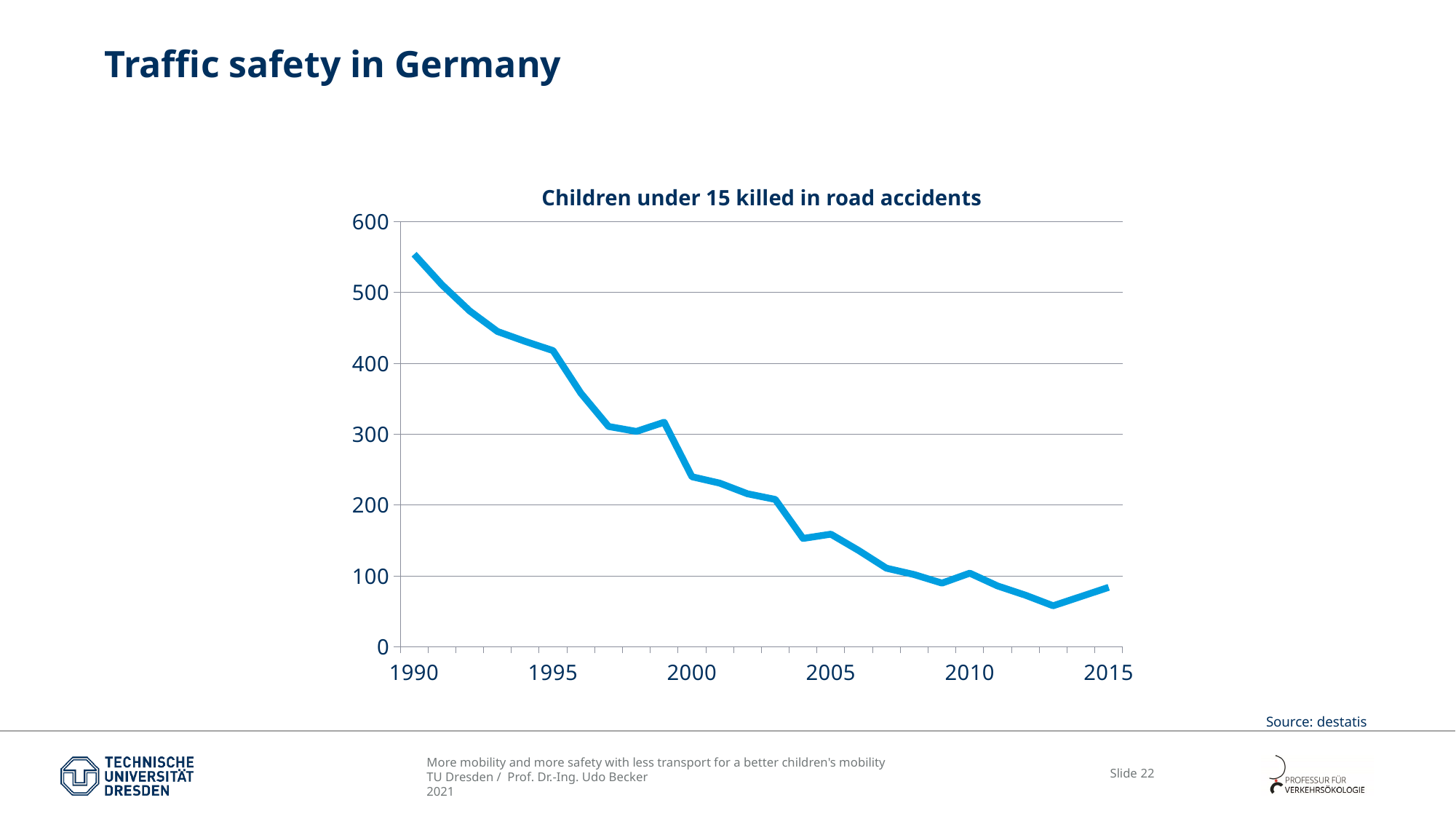
In which year is the number of children under 15 killed in road accidents highest? 1990 Is the value for 2000 greater or less than 200? greater Is the value for 2005 greater or less than 200? less What is the title of the chart? Children under 15 killed in road accidents Do the values in the chart generally rise or fall from 1990 to 2015? fall In which year is the number of children under 15 killed in road accidents lowest? 2013 Is the value for 2015 greater or less than 100? less What kind of chart is shown on the slide? line chart What source is cited for the chart data? destatis Which year has the larger value, 1990 or 2015? 1990